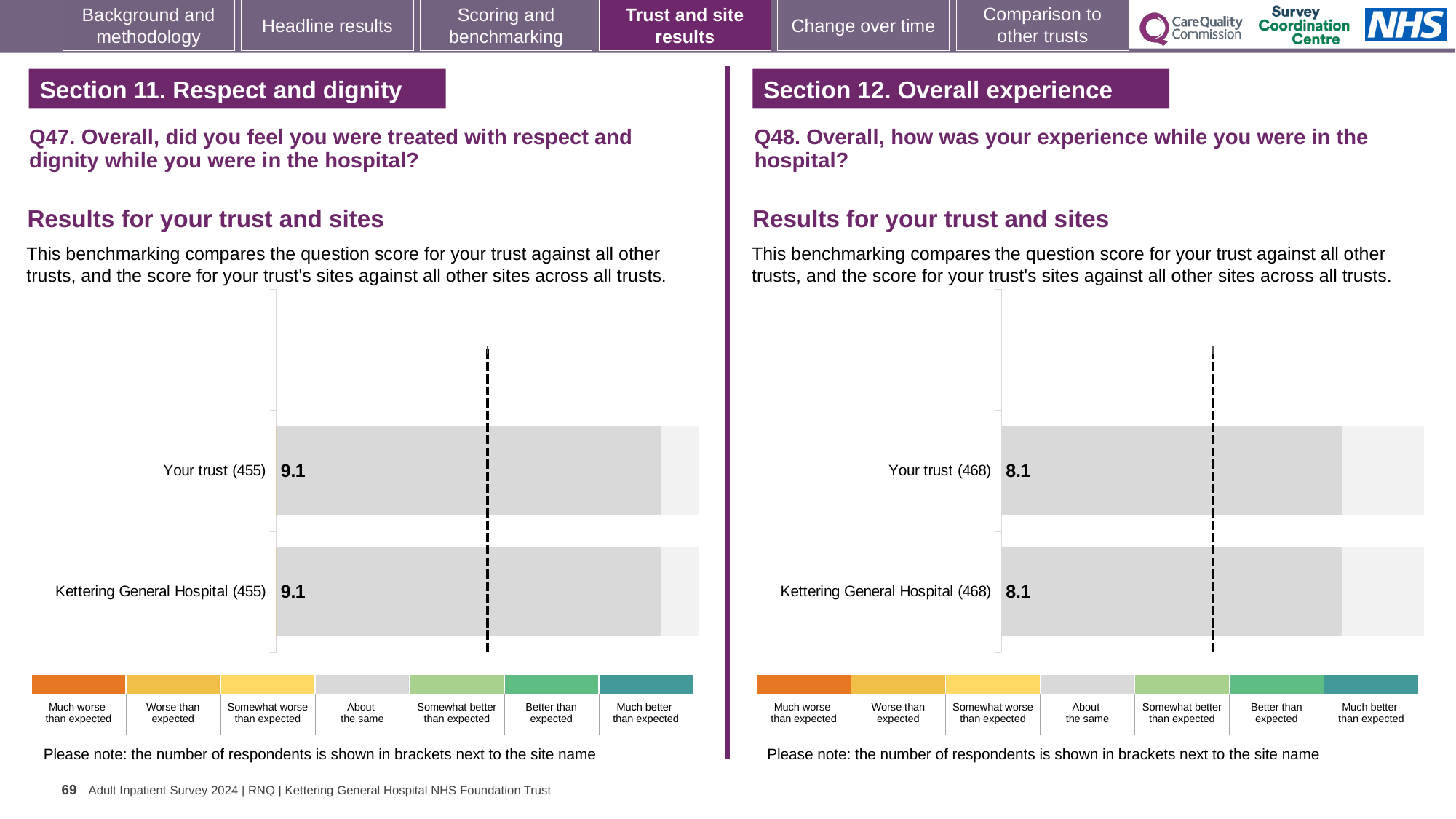
How many bars are plotted in the left chart (Q47, Respect and dignity)? 2 In the left chart (Q47, Respect and dignity), what is the difference between the score for Your trust and the score for Kettering General Hospital? 0 In the left chart (Q47, Respect and dignity), how many respondents are shown in brackets next to Your trust? 455 What kind of chart is used in the left chart (Q47, Respect and dignity)? Bar chart Is the score for Your trust in the left chart (Q47) larger or smaller than the score for Your trust in the right chart (Q48)? Larger In the right chart (Q48, Overall experience), what is the score for Your trust? 8.1 In the left chart (Q47, Respect and dignity), what is the score for Your trust? 9.1 In the right chart (Q48, Overall experience), what is the score for Kettering General Hospital? 8.1 In the left chart (Q47, Respect and dignity), what is the score for Kettering General Hospital? 9.1 In the right chart (Q48, Overall experience), how many respondents are shown in brackets next to Kettering General Hospital? 468 In the right chart (Q48, Overall experience), what is the difference between the score for Your trust and the score for Kettering General Hospital? 0 How many bars are plotted in the right chart (Q48, Overall experience)? 2